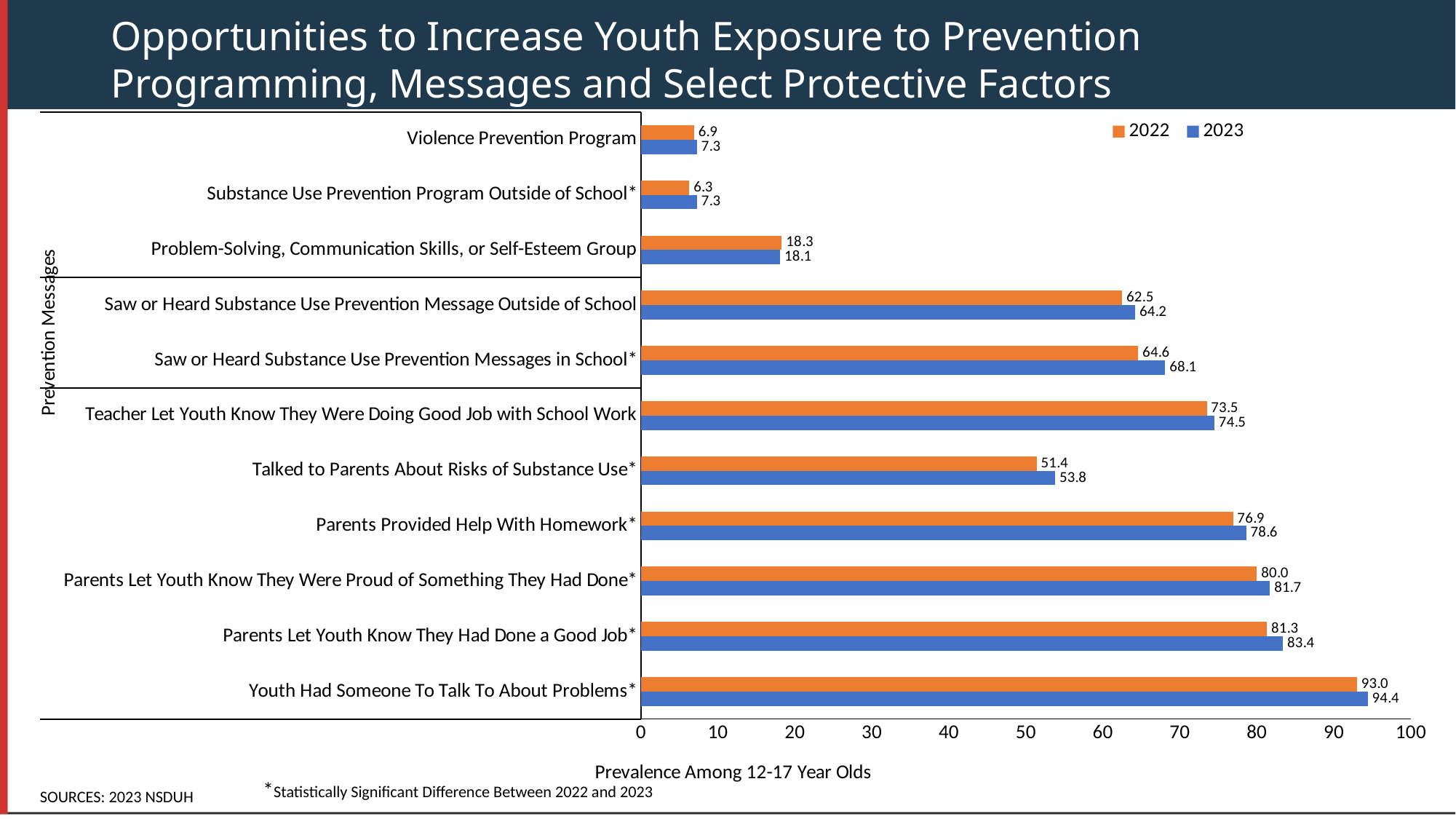
Which category has the lowest 2022 value? Substance Use Prevention Program Outside of School Is the 2023 value for Parents Provided Help With Homework greater or less than 70? greater What is the 2023 value for Youth Had Someone To Talk To About Problems? 94.4 What kind of chart is shown on the slide? Bar chart How many series does the legend list? 2 What is the x-axis label of the chart? Prevalence Among 12-17 Year Olds What is the difference between the 2023 and 2022 values for Saw or Heard Substance Use Prevention Messages in School? 3.5 Which is larger for Problem-Solving, Communication Skills, or Self-Esteem Group: the 2022 value or the 2023 value? 2022 What is the 2022 value for Violence Prevention Program? 6.9 How many categories are shown on the chart? 11 Which category has the highest 2023 value? Youth Had Someone To Talk To About Problems What is the 2022 value for Talked to Parents About Risks of Substance Use? 51.4